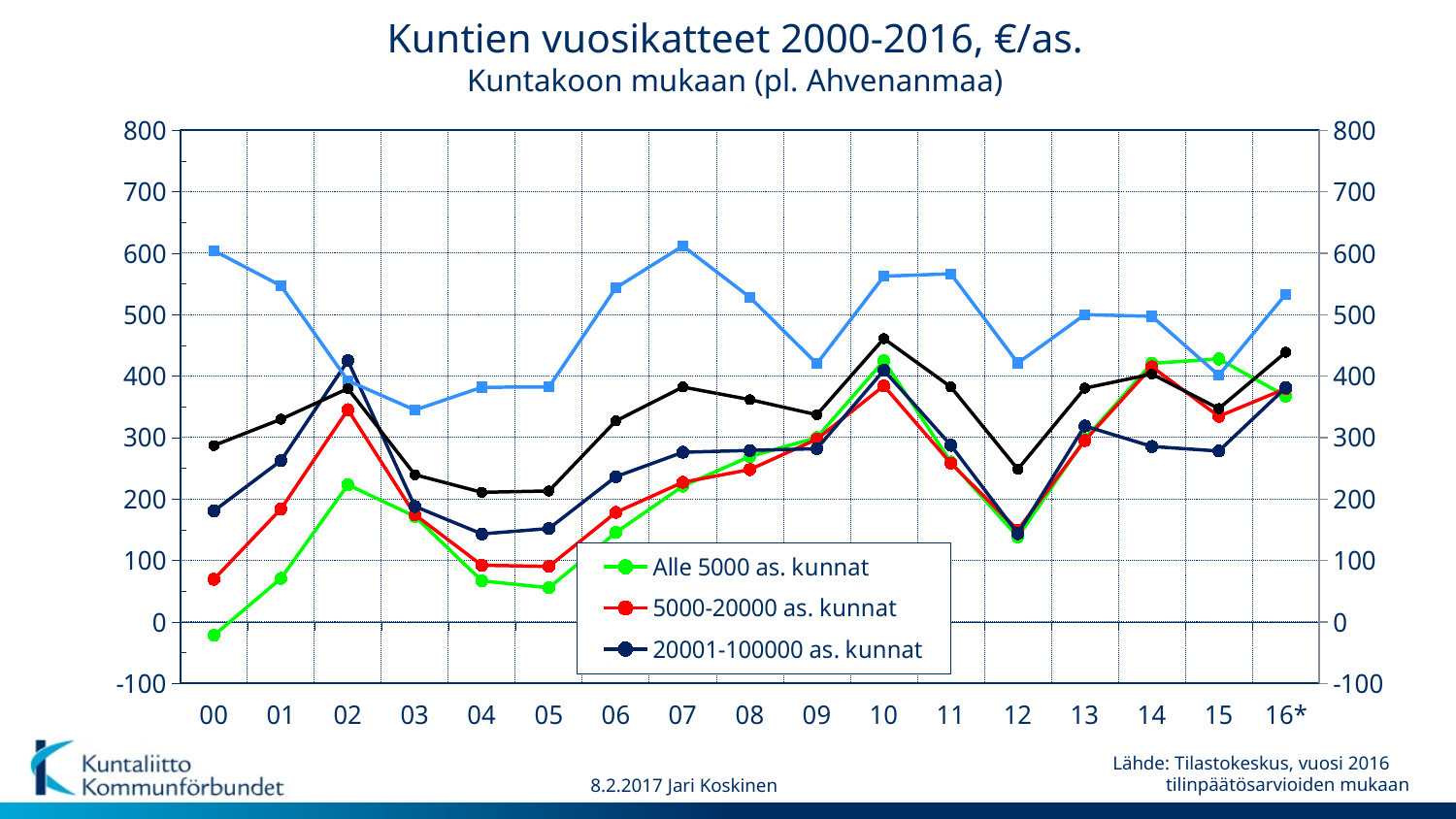
Is the value for 5000-20000 as. kunnat in 12 greater or less than 200? less Is the value for Alle 5000 as. kunnat in 00 greater or less than 0? less Is the value for 20001-100000 as. kunnat in 02 greater or less than 400? greater How many years are shown along the x axis? 17 In 04, which series has the higher value: 20001-100000 as. kunnat or Alle 5000 as. kunnat? 20001-100000 as. kunnat What is the title of the chart? Kuntien vuosikatteet 2000-2016, €/as. Does the Alle 5000 as. kunnat series rise or fall from 00 to 02? rise In which year does the Alle 5000 as. kunnat series reach its lowest value? 00 What kind of chart is shown on the slide? line chart How many series does the legend list? 3